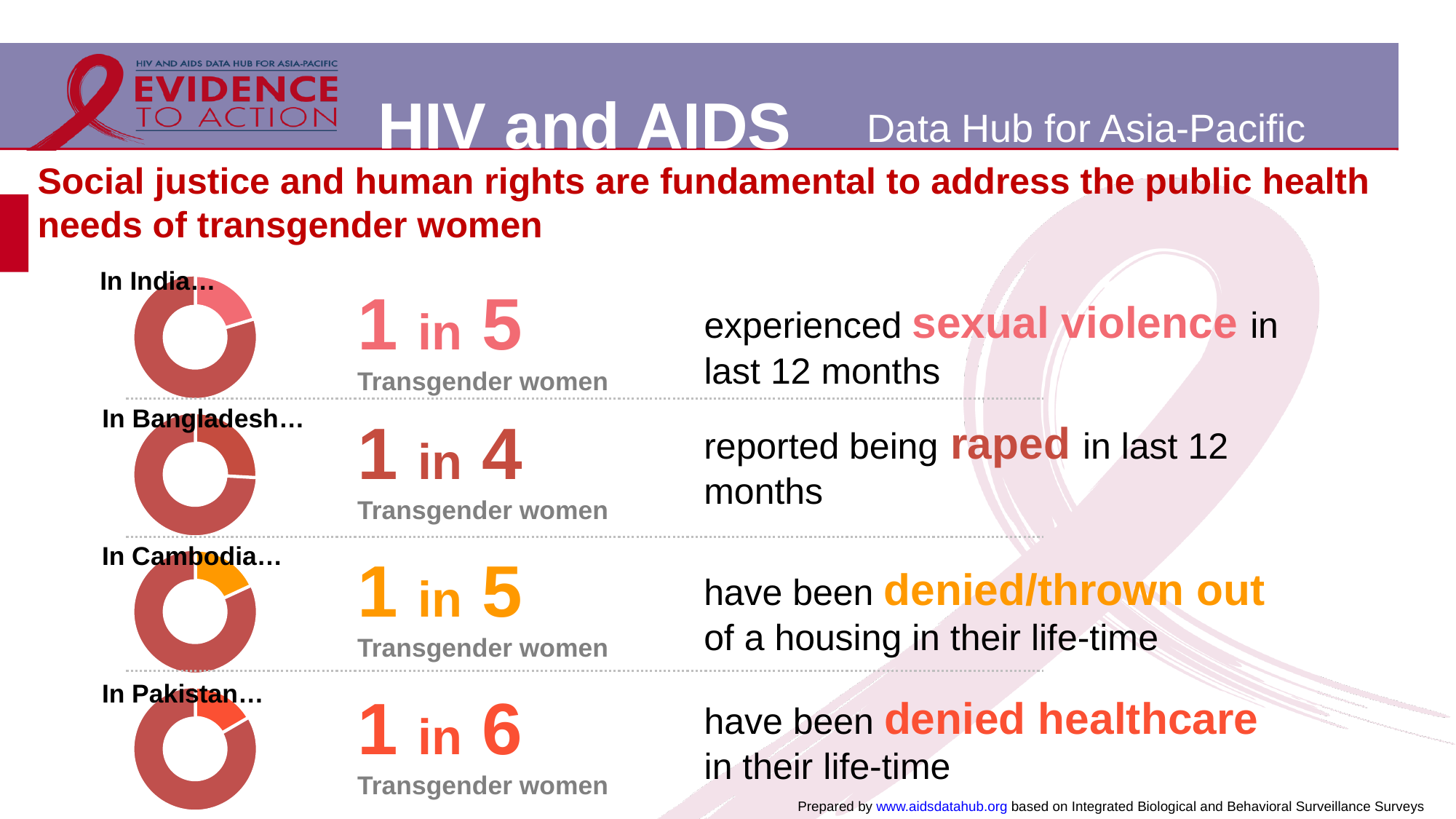
In the India donut chart, what proportion of transgender women experienced sexual violence in the last 12 months? 1 in 5 In the Cambodia donut chart, what proportion of transgender women have been denied/thrown out of housing in their lifetime? 1 in 5 What kind of chart is used to show the proportions for each country? Donut chart In the Bangladesh donut chart, what proportion of transgender women reported being raped in the last 12 months? 1 in 4 How many donut charts are shown on the slide? 4 What issue does the Pakistan donut chart represent? Denied healthcare in their life-time Which country's donut chart shows the smallest highlighted proportion? Pakistan Which country's donut chart shows the largest highlighted proportion? Bangladesh Is the highlighted proportion larger in the Bangladesh chart or the Cambodia chart? Bangladesh What colour is the highlighted slice in the Cambodia donut chart? Orange In the Pakistan donut chart, what proportion of transgender women have been denied healthcare in their lifetime? 1 in 6 Is the highlighted proportion larger in the India chart or the Pakistan chart? India